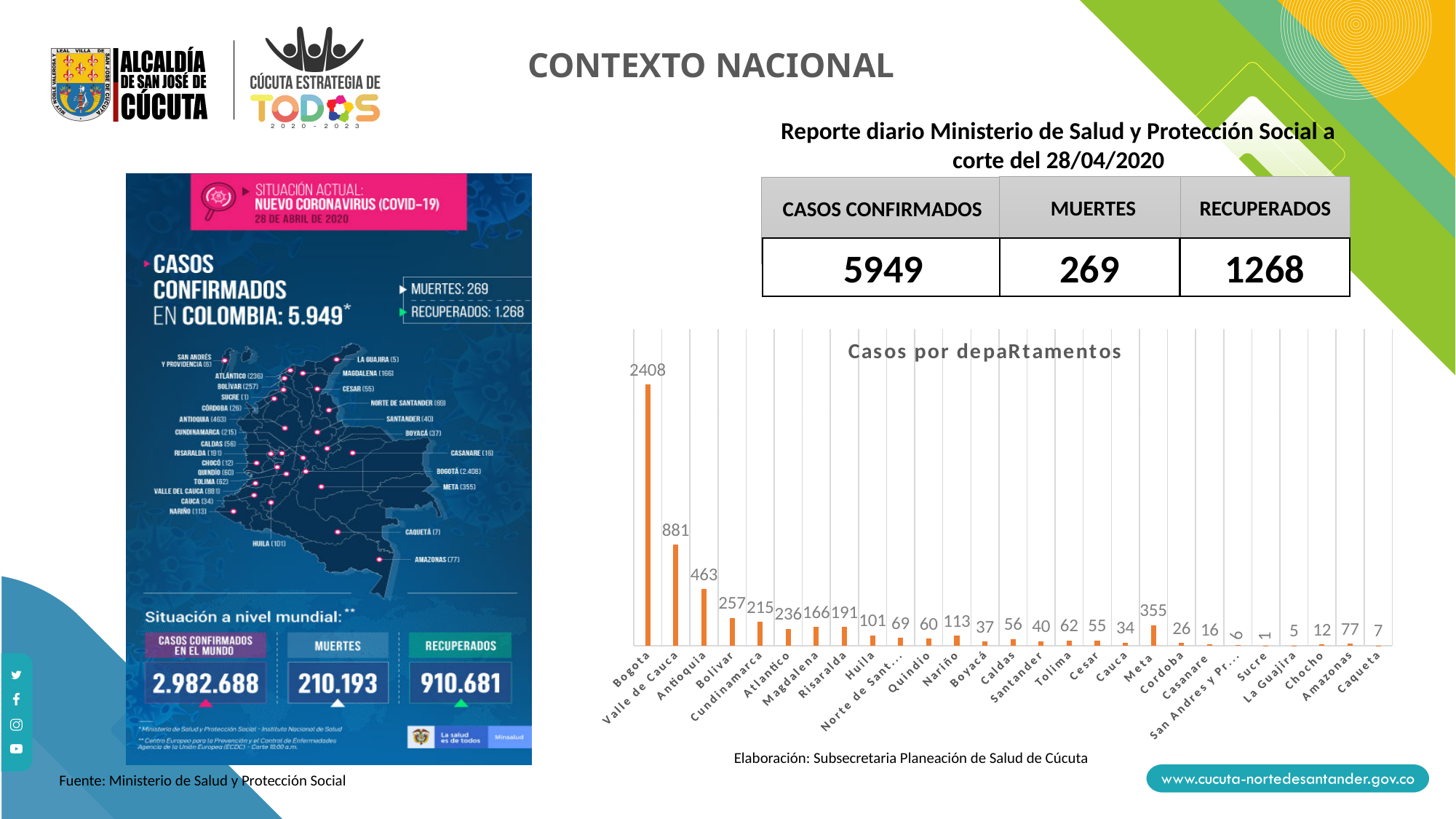
In the 'Casos por depaRtamentos' chart, what is the difference between the values for Antioquia and Bolivar? 206 What colour are the bars in the 'Casos por depaRtamentos' chart? Orange In the 'Casos por depaRtamentos' chart, which department has the highest value? Bogota In the 'Casos por depaRtamentos' chart, what is the difference between the values for Bogota and Valle de Cauca? 1527 In the 'Casos por depaRtamentos' chart, which is larger, the value for Atlantico or the value for Cundinamarca? Atlantico What kind of chart is 'Casos por depaRtamentos'? Bar chart In the 'Casos por depaRtamentos' chart, what is the value for Meta? 355 In the 'Casos por depaRtamentos' chart, which is larger, the value for Nariño or the value for Huila? Nariño In the 'Casos por depaRtamentos' chart, what is the value for Bogota? 2408 How many departments are shown in the 'Casos por depaRtamentos' chart? 27 In the 'Casos por depaRtamentos' chart, which department has the lowest value? Sucre In the 'Casos por depaRtamentos' chart, what is the value for Amazonas? 77